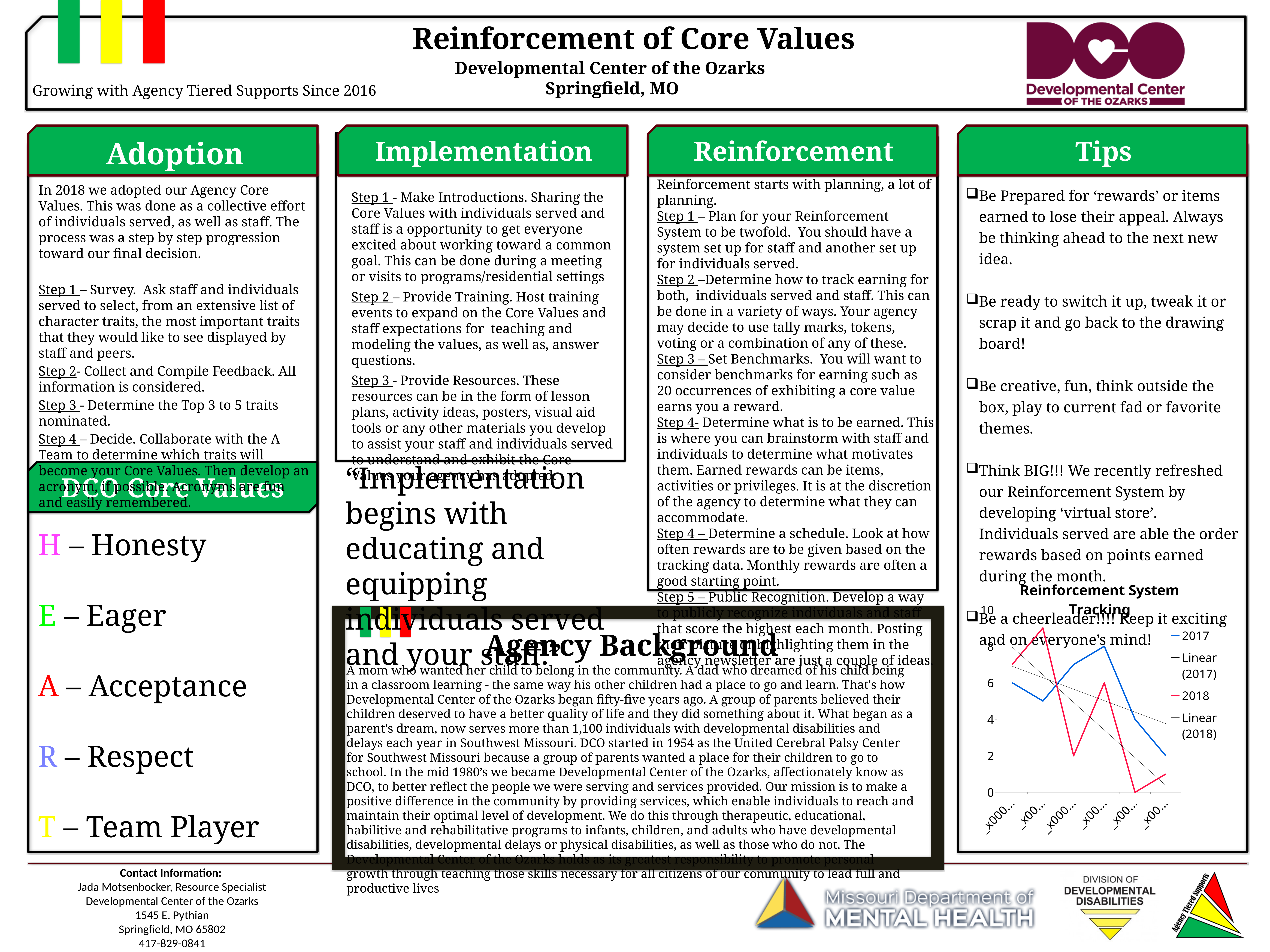
In the Reinforcement System Tracking chart, does the Linear (2018) trend line rise or fall along the x axis? fall What is the maximum value shown on the y axis of the Reinforcement System Tracking chart? 10 In the Reinforcement System Tracking chart, is the lowest value of the 2018 series greater or less than 2? less What kind of chart is the Reinforcement System Tracking chart? line chart In the Reinforcement System Tracking chart, is the highest value of the 2018 series greater or less than 8? greater What is the title of the chart in the Tips panel? Reinforcement System Tracking How many entries does the legend of the Reinforcement System Tracking chart list? 4 In the Reinforcement System Tracking chart, is the lowest value of the 2017 series greater or less than 4? less How many points are plotted along the x axis of the Reinforcement System Tracking chart? 6 In the Reinforcement System Tracking chart, does the Linear (2017) trend line rise or fall along the x axis? fall